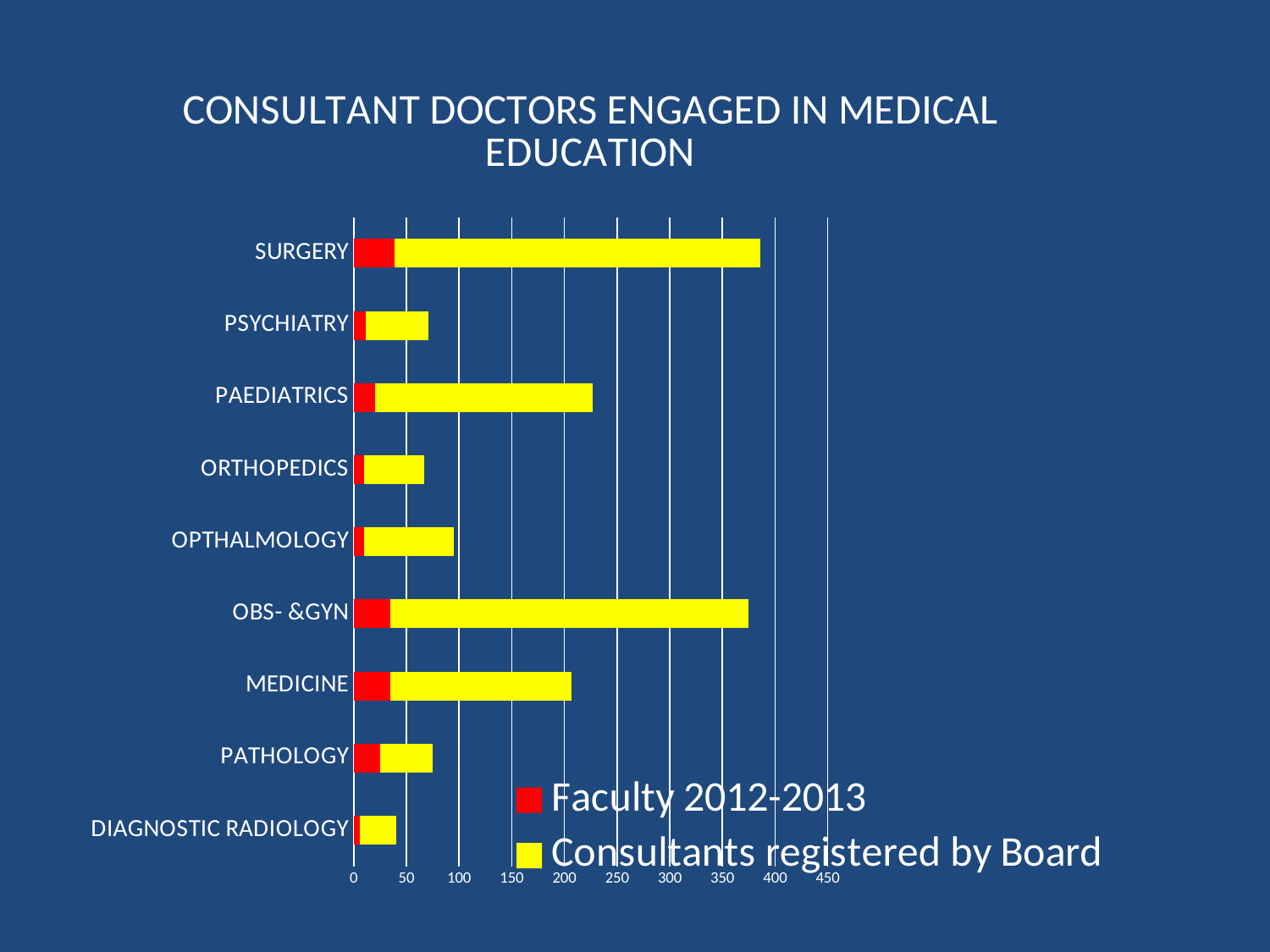
How many specialties (categories) are shown on the chart? 9 Is the total bar for PATHOLOGY greater or less than 100? less How many series does the legend list? 2 Is the total bar for OBS- &GYN greater or less than 300? greater Which has the longer total bar, SURGERY or PAEDIATRICS? SURGERY Is the total bar for SURGERY greater or less than 350? greater Which specialty has the shortest total bar? DIAGNOSTIC RADIOLOGY What kind of chart is shown on the slide? stacked bar chart Which colour represents the 'Consultants registered by Board' series? yellow Which has the longer total bar, PATHOLOGY or DIAGNOSTIC RADIOLOGY? PATHOLOGY